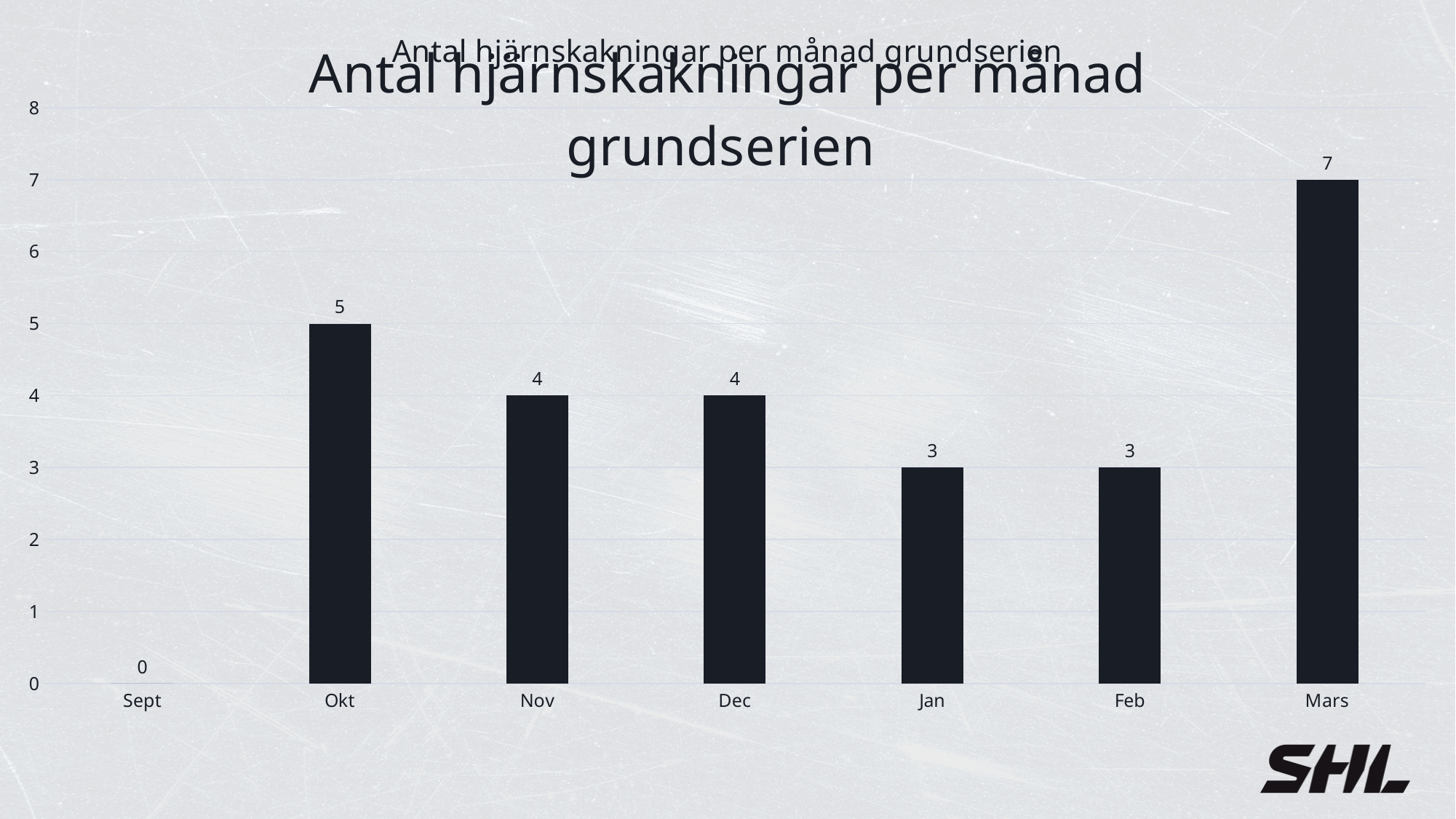
What kind of chart is this? Bar chart What is the title of the chart? Antal hjärnskakningar per månad grundserien What is the difference between the values for Mars and Okt? 2 What is the value for Jan? 3 What is the value for Mars? 7 Which month has the highest value? Mars Which is larger, the value for Okt or the value for Nov? Okt How many months are shown on the x axis? 7 What is the value for Okt? 5 What is the value for Sept? 0 Which month has the lowest value? Sept Do the values rise or fall from Okt to Jan? Fall